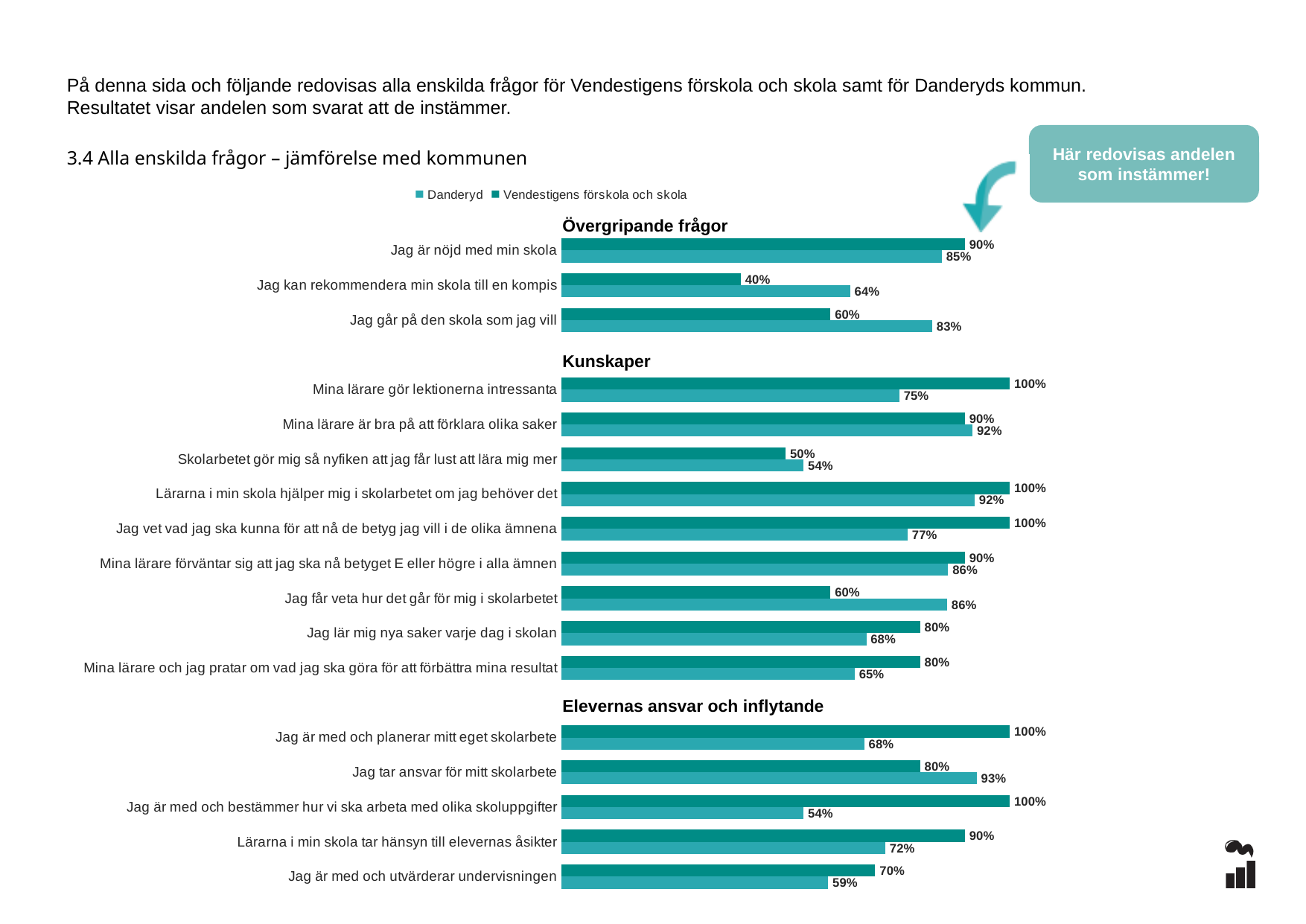
What is the value for Danderyd for "Mina lärare gör lektionerna intressanta"? 75% How many series does the legend list? 2 Which question has the lowest value for Danderyd? Skolarbetet gör mig så nyfiken att jag får lust att lära mig mer and Jag är med och bestämmer hur vi ska arbeta med olika skoluppgifter (both 54%) What is the value for Vendestigens förskola och skola for "Jag är nöjd med min skola"? 90% How many questions are shown under the heading "Kunskaper"? 9 Which question has the lowest value for Vendestigens förskola och skola? Jag kan rekommendera min skola till en kompis What kind of chart is shown on the slide? bar chart What is the value for Danderyd for "Jag kan rekommendera min skola till en kompis"? 64% Which is larger for "Jag tar ansvar för mitt skolarbete": Danderyd or Vendestigens förskola och skola? Danderyd Which is larger for "Jag får veta hur det går för mig i skolarbetet": Danderyd or Vendestigens förskola och skola? Danderyd What is the value for Danderyd for "Jag är med och utvärderar undervisningen"? 59% What is the difference between Vendestigens förskola och skola and Danderyd for "Jag är med och bestämmer hur vi ska arbeta med olika skoluppgifter"? 46 percentage points